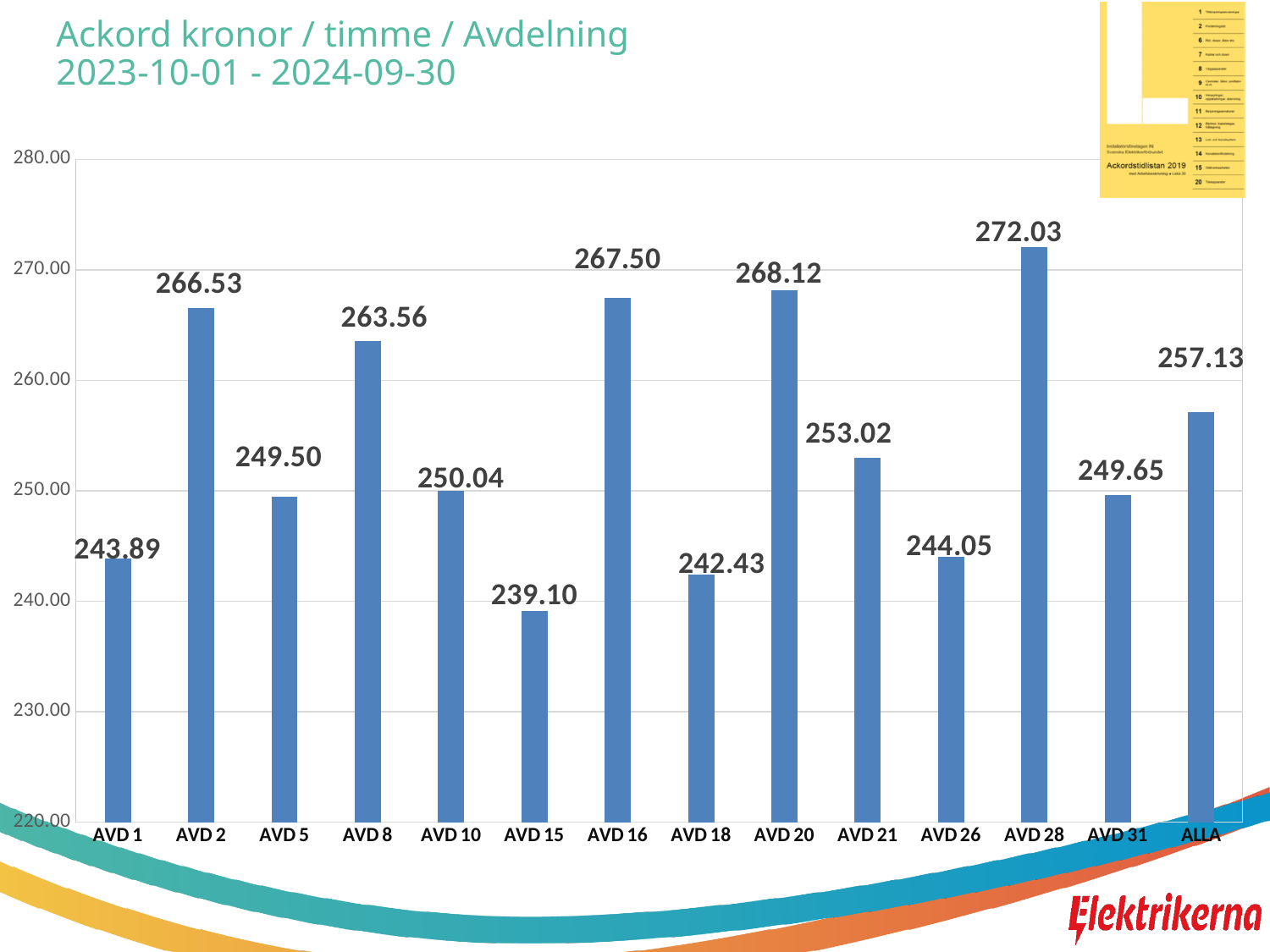
What is the value for AVD 28? 272.03 Which is larger, the value for AVD 8 or the value for AVD 21? AVD 8 What kind of chart is shown on the slide? bar chart What is the title of the chart? Ackord kronor / timme / Avdelning 2023-10-01 - 2024-09-30 Which category has the highest value? AVD 28 Which category has the lowest value? AVD 15 What is the difference between the values for AVD 2 and AVD 1? 22.64 What is the difference between the values for AVD 28 and AVD 15? 32.93 What is the value for AVD 15? 239.10 How many categories are shown on the x axis? 14 What is the value for ALLA? 257.13 Is the value for AVD 21 greater or less than 250.00? greater